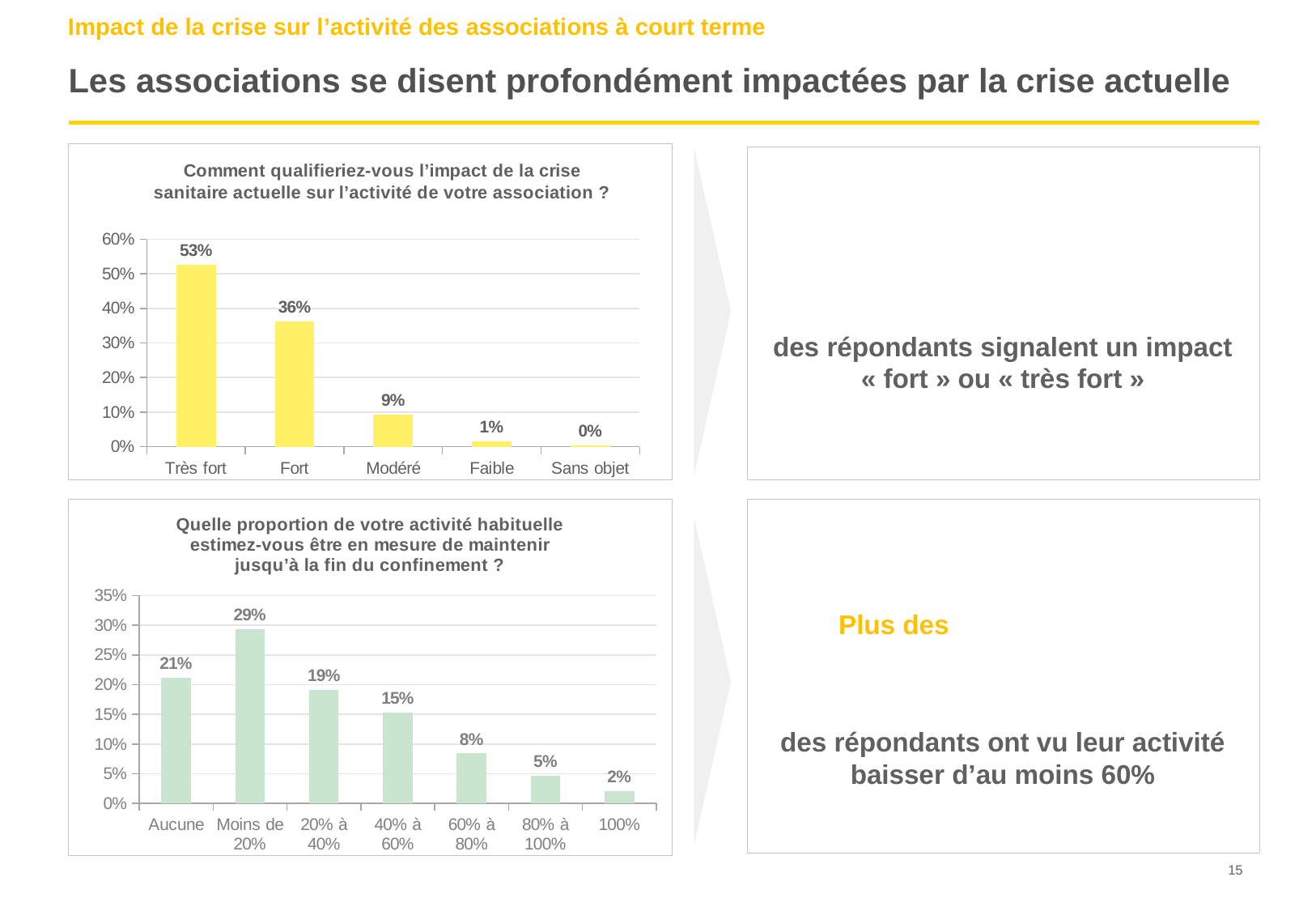
What type of chart is the top chart? Bar chart In the bottom chart, what is the value for "Moins de 20%"? 29% In the bottom chart, how many categories are shown on the x axis? 7 In the bottom chart, what is the difference between the values for "60% à 80%" and "80% à 100%"? 3% In the bottom chart, which is larger: the value for "20% à 40%" or the value for "40% à 60%"? 20% à 40% In the bottom chart, what is the value for "Aucune"? 21% In the bottom chart, which category has the lowest value? 100% In the top chart, what is the difference between the values for "Très fort" and "Fort"? 17% In the top chart, what percentage of respondents answered "Très fort"? 53% In the top chart, what is the value for "Modéré"? 9% In the top chart, which category has the highest value? Très fort In the top chart, how many categories are shown on the x axis? 5